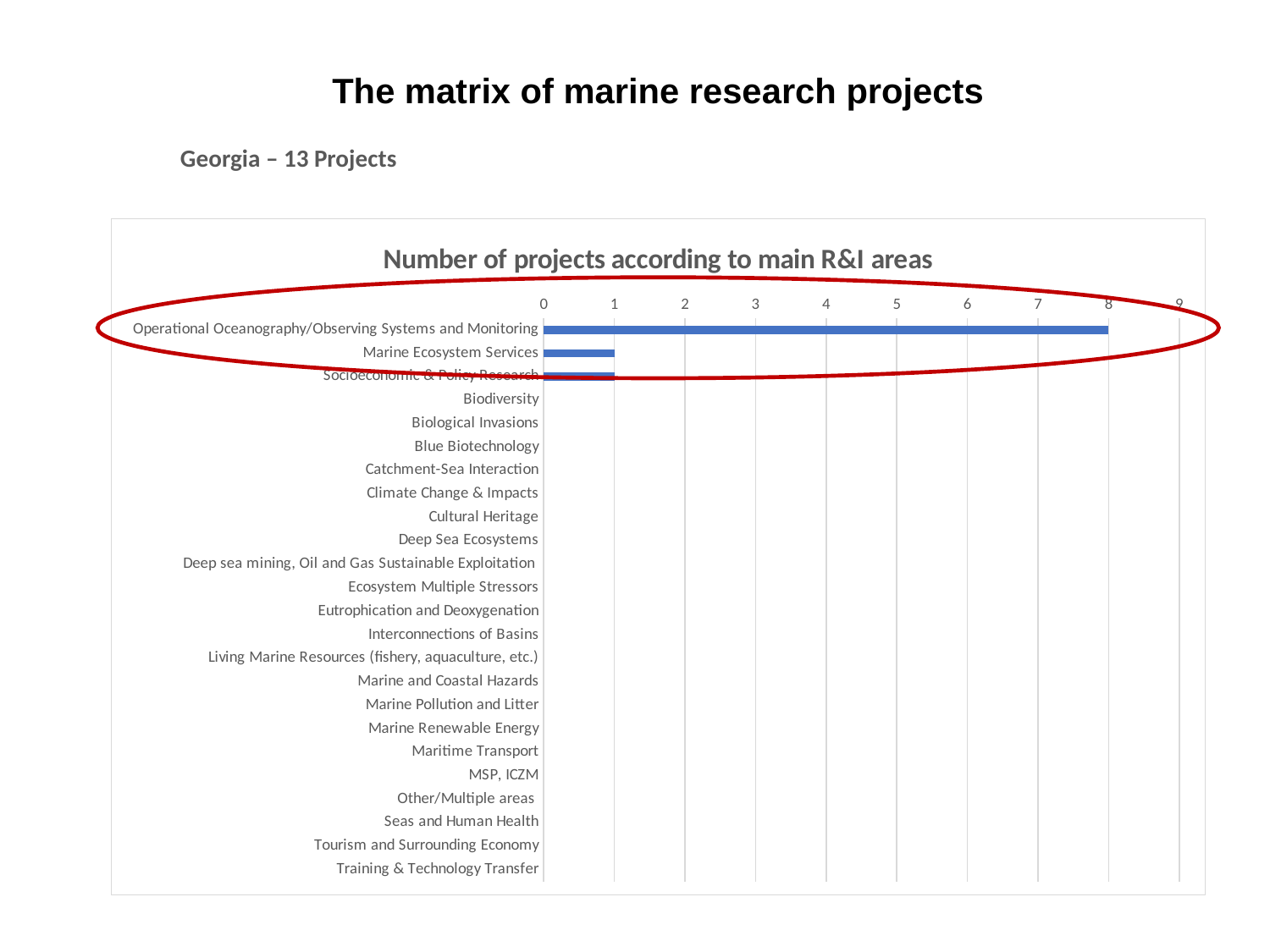
Is the value for Operational Oceanography/Observing Systems and Monitoring greater or less than 5? greater How many projects are in the Biodiversity area? 0 What type of chart is shown on the slide? bar chart Which has more projects, Operational Oceanography/Observing Systems and Monitoring or Marine Ecosystem Services? Operational Oceanography/Observing Systems and Monitoring How many projects are in the Operational Oceanography/Observing Systems and Monitoring area? 8 What is the difference between the number of projects for Operational Oceanography/Observing Systems and Monitoring and for Marine Ecosystem Services? 7 How many projects are in the Marine Ecosystem Services area? 1 What is the highest value shown on the chart's horizontal axis? 9 Which R&I area has the highest number of projects? Operational Oceanography/Observing Systems and Monitoring How many R&I area categories are listed on the chart's axis? 24 How many categories on the chart have a non-zero number of projects? 3 What is the title of the chart? Number of projects according to main R&I areas